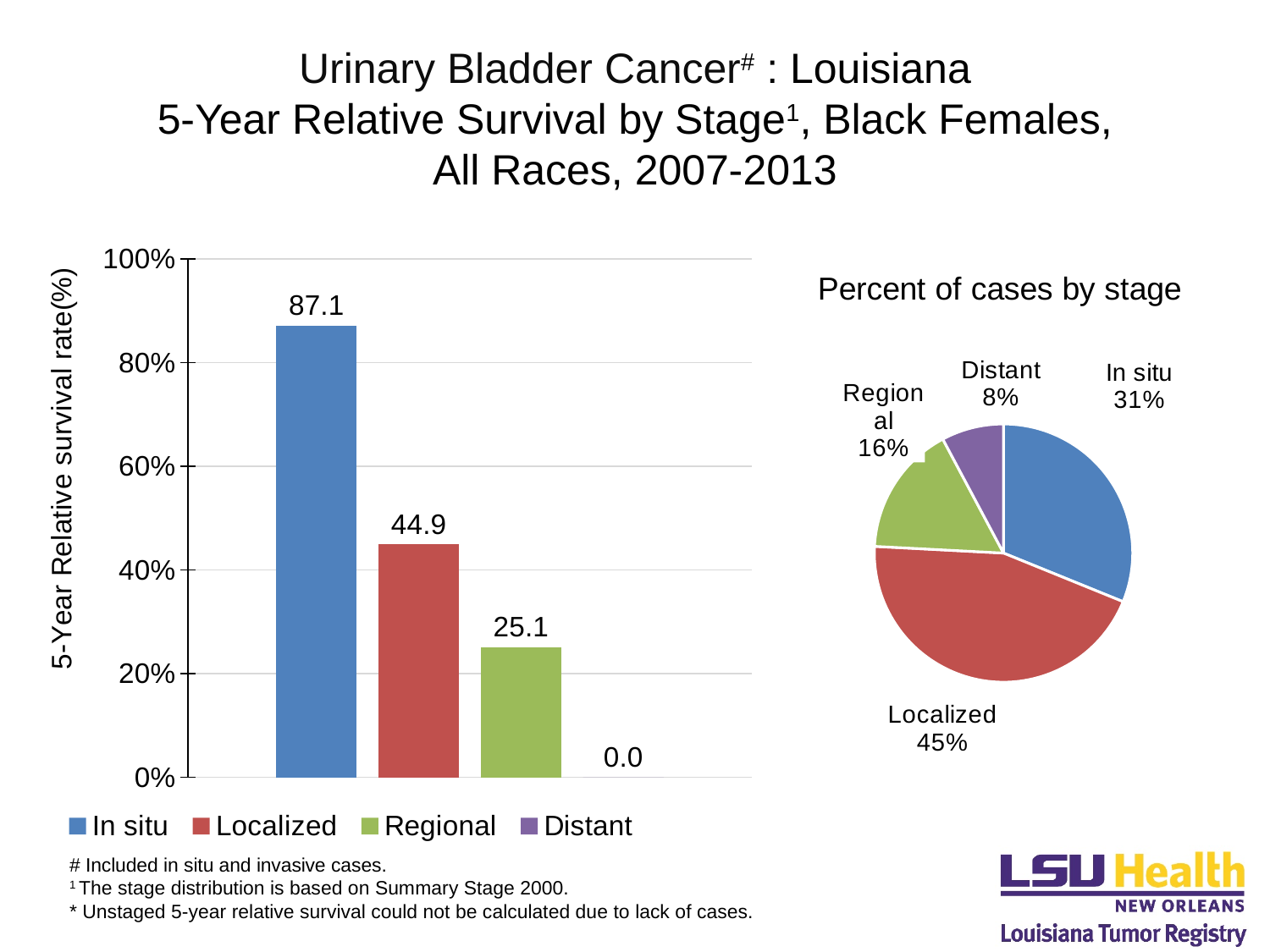
In the 'Percent of cases by stage' pie chart, what is the difference between the In situ and Regional shares? 15% In the bar chart on the left, what is the value shown for the Distant stage? 0.0 What kind of chart is the 'Percent of cases by stage' chart on the right? Pie chart In the 'Percent of cases by stage' pie chart, what share of cases is Localized? 45% In the bar chart on the left, which stage has the lowest 5-year relative survival rate? Distant In the bar chart on the left, how many series does the legend list? 4 In the 'Percent of cases by stage' pie chart, which stage has the smallest share of cases? Distant In the bar chart on the left, what is the 5-year relative survival rate for the In situ stage? 87.1 In the bar chart on the left, which is larger, the survival rate for Localized or for Regional? Localized In the bar chart on the left, which stage has the highest 5-year relative survival rate? In situ In the bar chart on the left, what is the 5-year relative survival rate for the Regional stage? 25.1 In the bar chart on the left, what is the difference between the In situ and Localized survival rates? 42.2